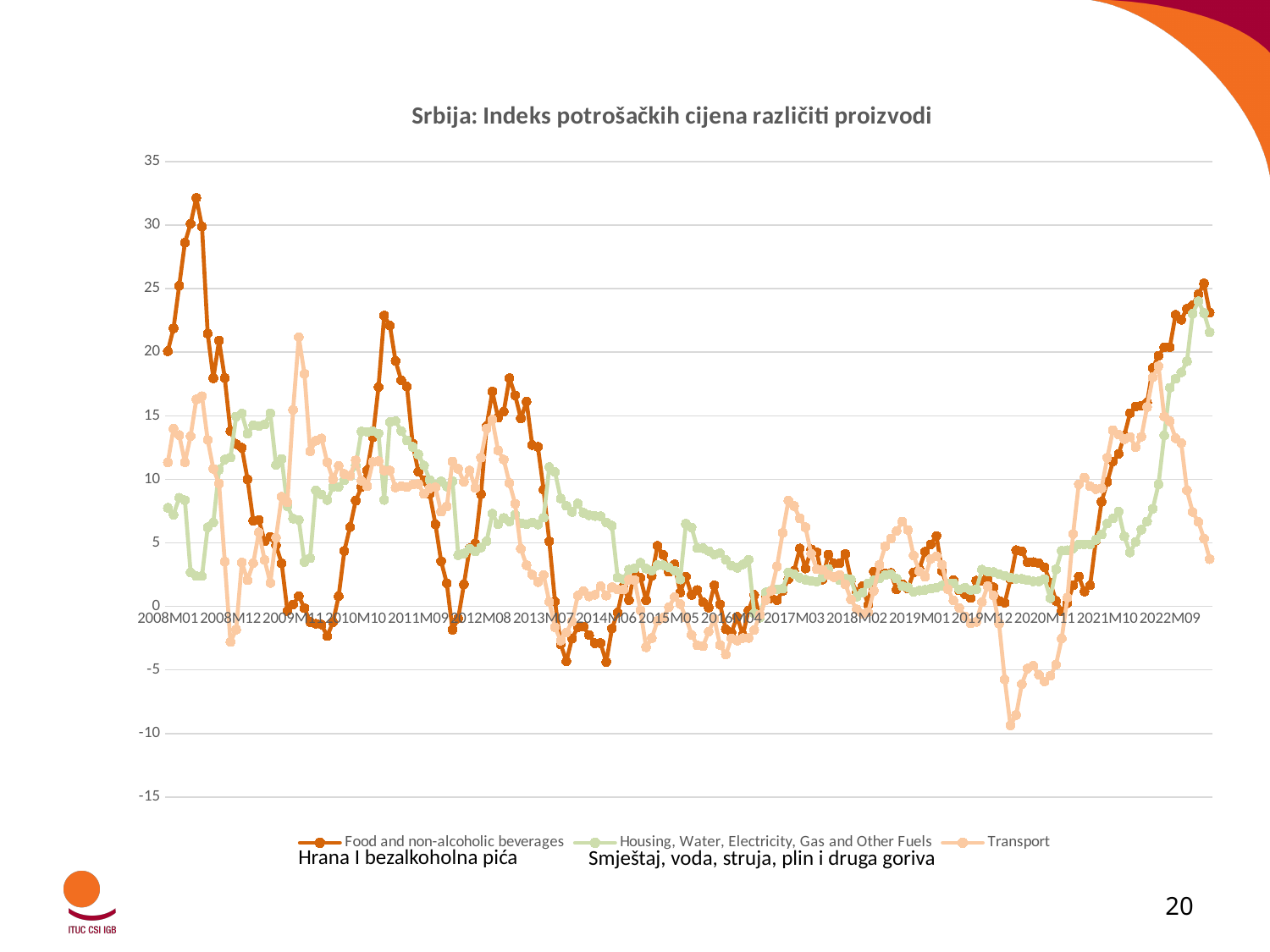
Does the Food and non-alcoholic beverages series rise or fall between 2020M11 and 2022M09? rise Which series reaches the highest value anywhere on the chart? Food and non-alcoholic beverages Which series is shown in the lightest (pale orange) colour in the legend? Transport Is the value of the Housing, Water, Electricity, Gas and Other Fuels series at 2008M01 greater or less than 10? less What is the title of the chart? Srbija: Indeks potrošačkih cijena različiti proizvodi Is the value of the Food and non-alcoholic beverages series at 2022M09 greater or less than 20? greater Is the lowest value of the Transport series (between 2019M12 and 2020M11) greater or less than -5? less What kind of chart is shown on the slide? line chart How many series does the legend list? 3 At 2008M01, which series has the larger value: Food and non-alcoholic beverages or Housing, Water, Electricity, Gas and Other Fuels? Food and non-alcoholic beverages Which series reaches the lowest value anywhere on the chart? Transport